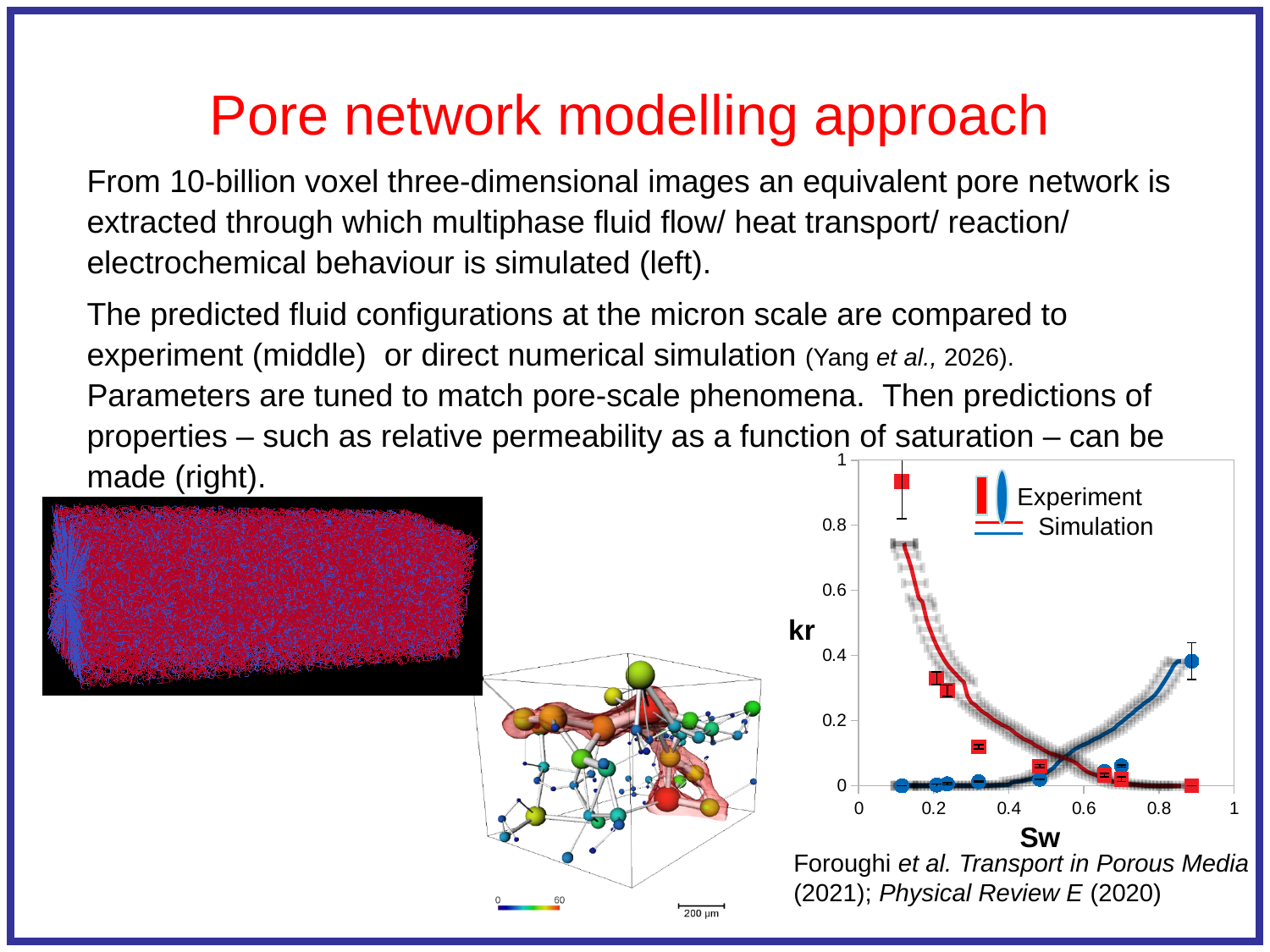
At Sw = 0.2, which curve has the higher kr value, the red one or the blue one? The red one Is the kr value of the blue experiment point near Sw = 0.9 greater or less than 0.2? greater Is the kr value of the red experiment point near Sw = 0.1 greater or less than 0.8? greater How many entries does the legend of the kr versus Sw chart list? 2 What is the label of the horizontal axis of the chart? Sw Does the blue curve rise or fall as Sw increases? Rise What kind of chart is shown on the right of the slide? A line chart with scatter points What is the highest value shown on the Sw axis? 1 What is the label of the vertical axis of the chart? kr Is the kr value of the blue experiment point near Sw = 0.9 greater or less than 0.6? less Does the red curve rise or fall as Sw increases? Fall